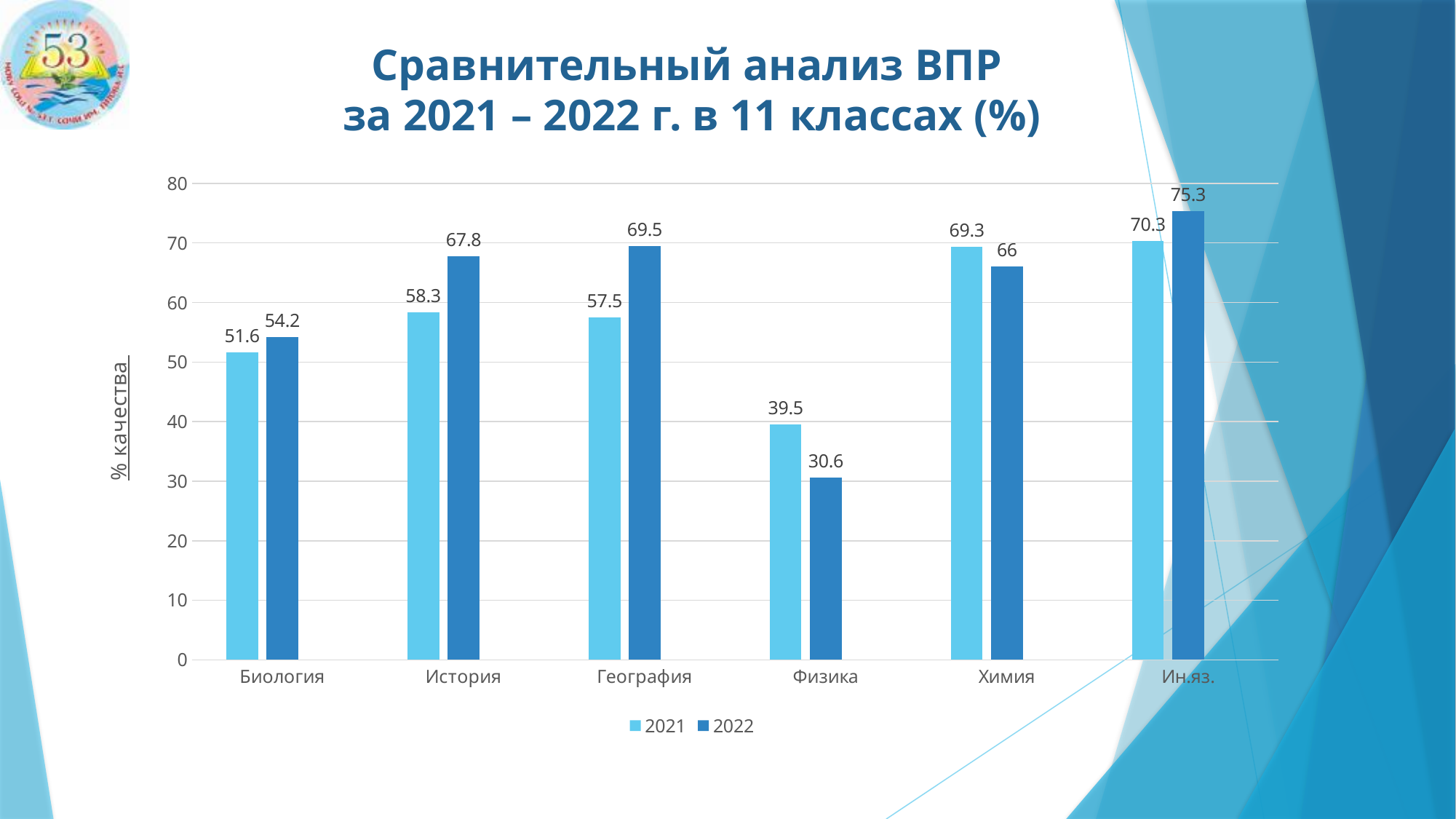
What is the 2021 value for Физика? 39.5 How many series does the legend list? 2 Which subject has the highest 2022 value? Ин.яз. Which is larger for Химия: the 2021 value or the 2022 value? 2021 What is the label of the vertical axis? % качества What is the 2022 value for История? 67.8 Which subject has the lowest 2021 value? Физика How many subjects are shown on the x axis? 6 Is the 2022 value for Физика greater or less than 40? less What is the 2022 value for Химия? 66 What is the difference between the 2022 and 2021 values for География? 12 What kind of chart is shown on the slide? bar chart